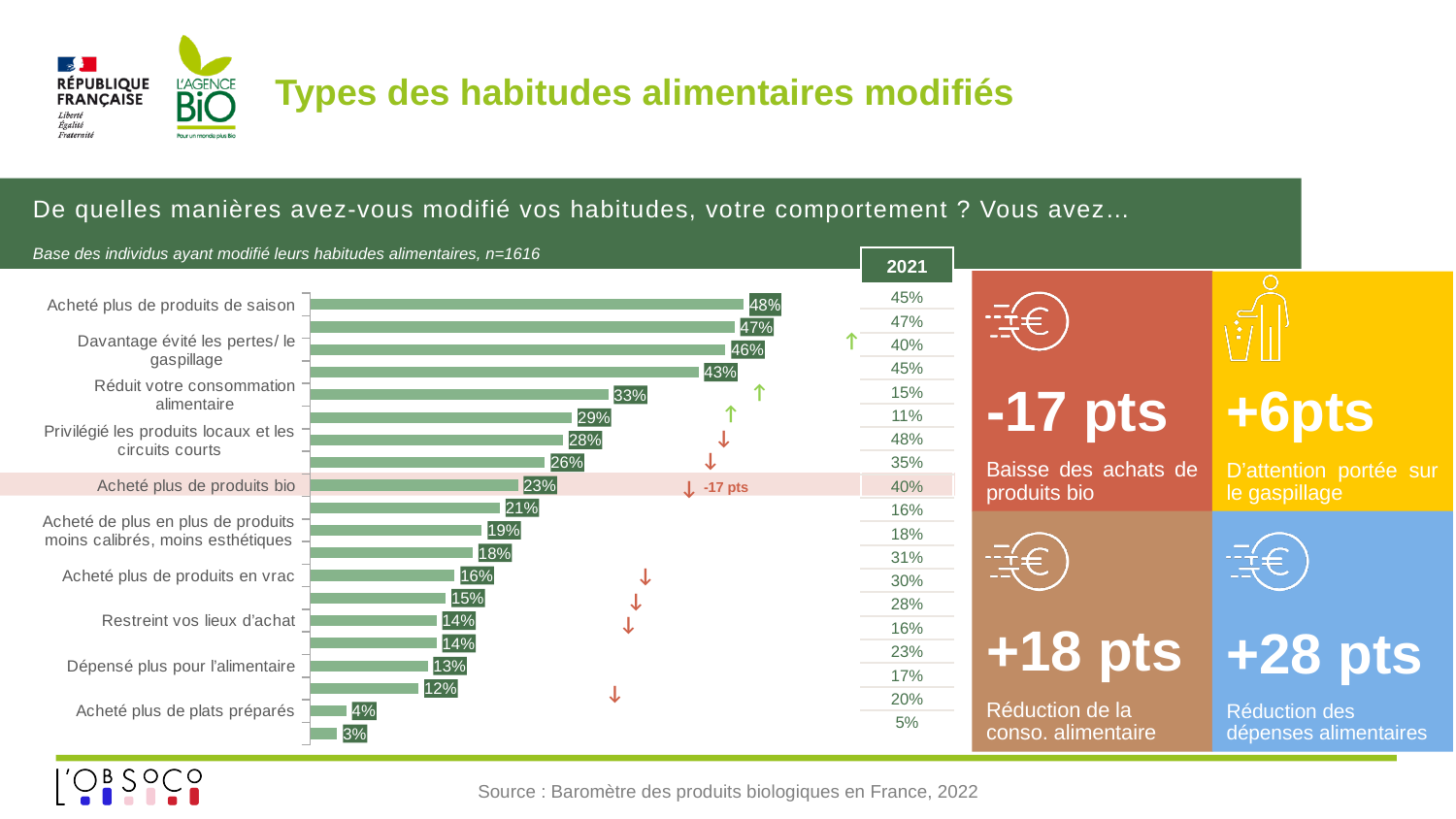
What type of chart is shown on the slide? bar chart What is the difference between the values for "Acheté plus de produits de saison" and "Acheté plus de produits bio"? 25 pts What is the value for "Réduit votre consommation alimentaire"? 33% Which is larger, the value for "Restreint vos lieux d'achat" or for "Acheté plus de plats préparés"? Restreint vos lieux d'achat What change in points is annotated next to the "Acheté plus de produits bio" bar? -17 pts What is the value for "Acheté plus de produits bio"? 23% Do the bar values increase or decrease going from the top of the chart to the bottom? decrease What is the value for "Acheté plus de produits de saison"? 48% What is the smallest value shown on any bar in the chart? 3% Which category has the highest value in the chart? Acheté plus de produits de saison What is the value for "Acheté plus de plats préparés"? 4% What is the value for "Acheté plus de produits en vrac"? 16%